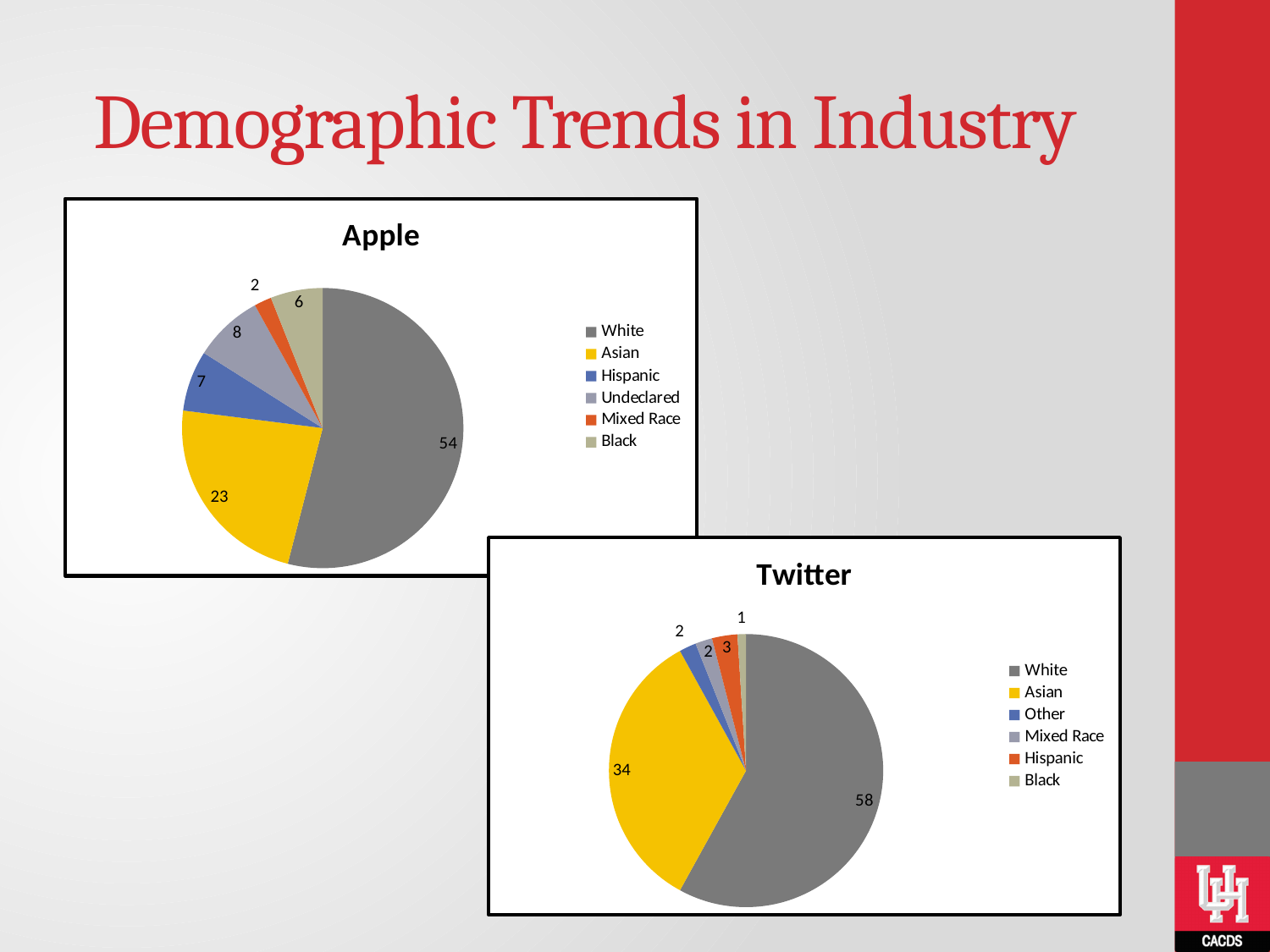
What is the difference between the White values in the Twitter chart and the Apple chart? 4 In the Apple chart, what value is shown for Asian? 23 In the Apple chart, which category has the largest slice? White In the Apple chart, which is larger, Hispanic or Black? Hispanic In the Twitter chart, what value is shown for Hispanic? 3 How many categories does the legend of the Twitter chart list? 6 In the Apple chart, what colour is the Asian slice? Yellow In the Apple chart, what value is shown for White? 54 In the Twitter chart, which category has the smallest slice? Black What type of chart is the Apple chart? Pie chart In the Apple chart, what value is shown for Undeclared? 8 In the Twitter chart, what value is shown for Asian? 34